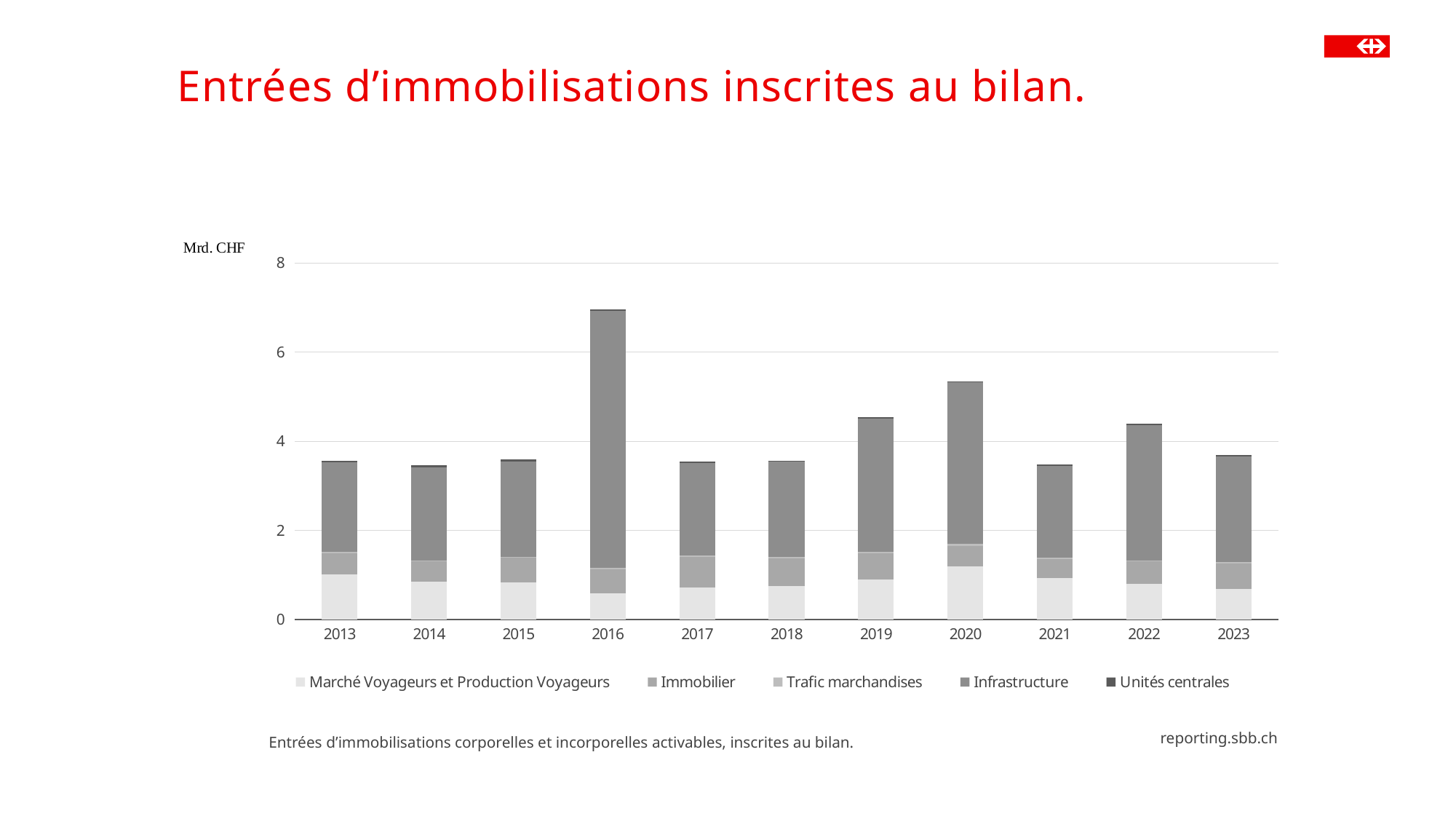
What unit is shown on the chart's vertical axis? Mrd. CHF Which year has the highest total bar in the chart? 2016 What kind of chart is shown on the slide? stacked bar chart How many years are shown on the x axis of the chart? 11 Is the total value for 2016 greater or less than 6? greater Is the total value for 2013 greater or less than 4? less What is the title of the slide? Entrées d’immobilisations inscrites au bilan. Which year has the larger total bar, 2019 or 2020? 2020 Which year has the larger total bar, 2016 or 2022? 2016 Is the total value for 2023 greater or less than 4? less How many series does the chart's legend list? 5